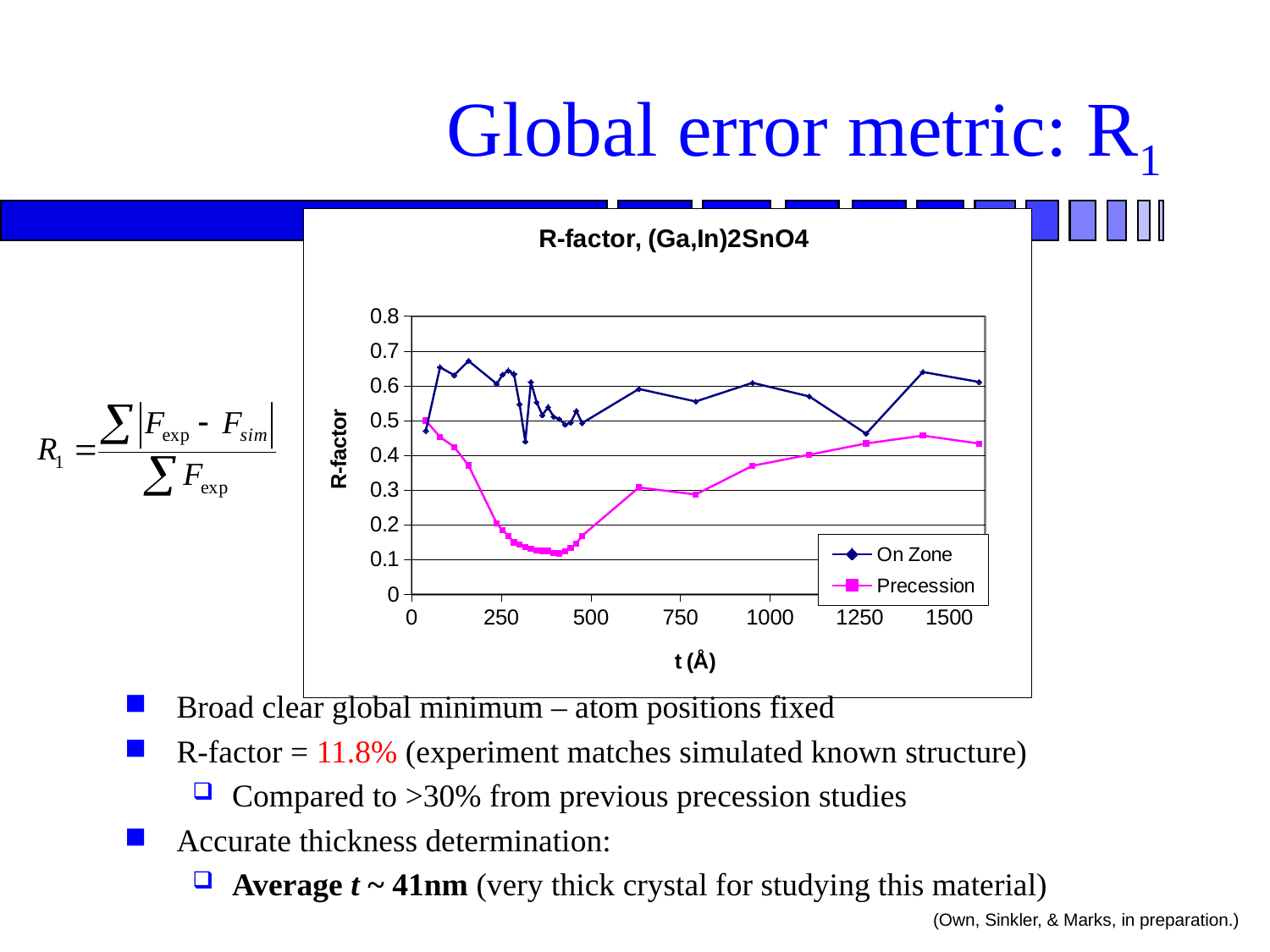
Which series has the lower R-factor at t = 400 Å, On Zone or Precession? Precession Does the Precession R-factor rise or fall as t increases from 500 to 1500 Å? rise Does the Precession R-factor rise or fall as t increases from 0 to 400 Å? fall What kind of chart is shown on the slide? line chart How many series does the chart legend list? 2 Is the On Zone R-factor at t = 1000 Å greater or less than 0.5? greater Which series reaches the lowest R-factor anywhere on the chart? Precession Is the Precession R-factor at t = 400 Å greater or less than 0.2? less Is the On Zone R-factor at t = 150 Å greater or less than 0.6? greater What is the label of the x axis of the chart? t (Å) What is the title of the chart? R-factor, (Ga,In)2SnO4